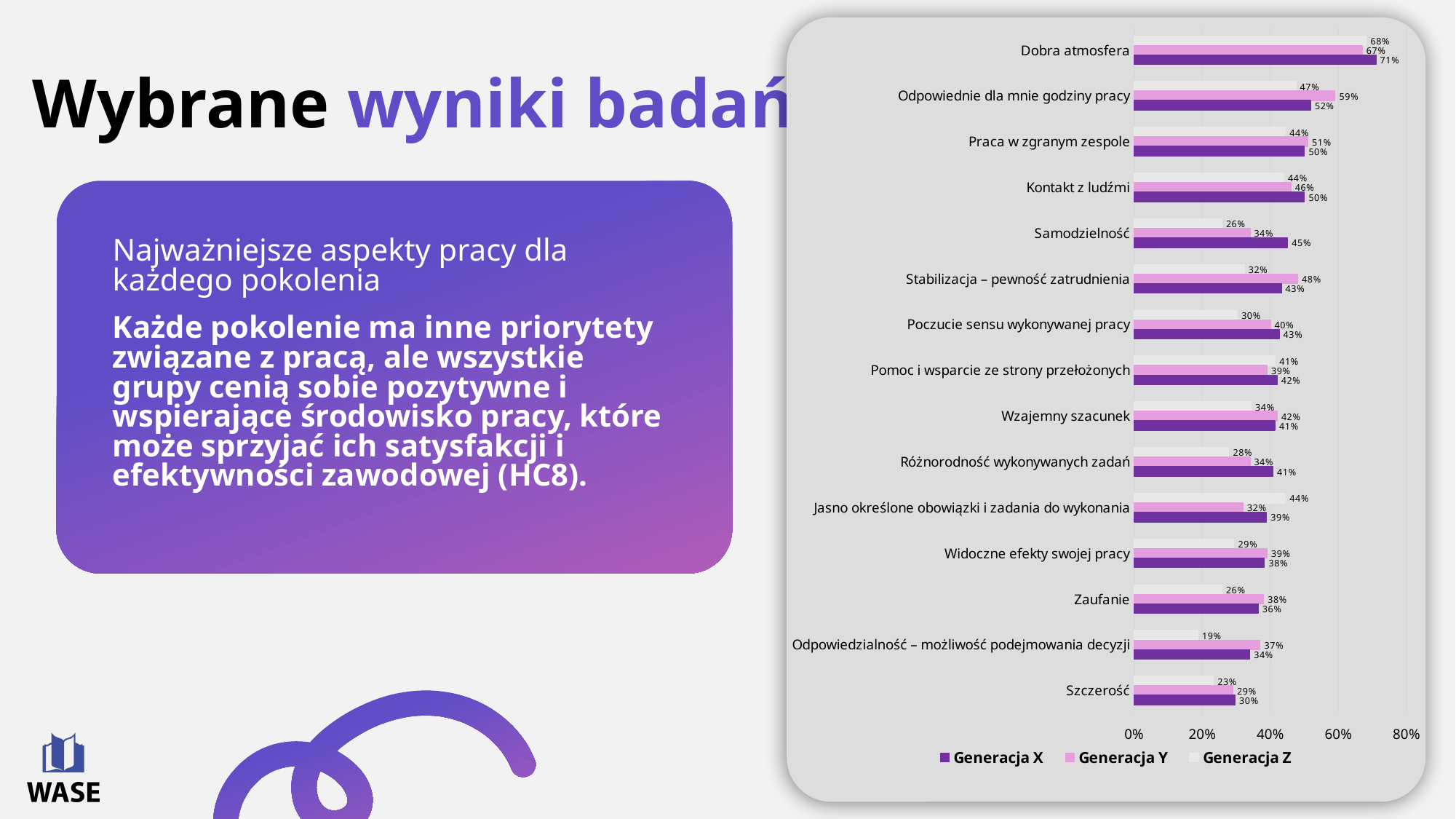
What is the value for Generacja Z for "Odpowiedzialność – możliwość podejmowania decyzji"? 19% How many categories are shown in the chart? 15 What is the difference between the Generacja X and Generacja Z values for "Samodzielność"? 19% For "Stabilizacja – pewność zatrudnienia", which is larger: the Generacja Y value or the Generacja X value? Generacja Y Which series is shown in dark purple in the legend? Generacja X What is the value for Generacja Y for "Odpowiednie dla mnie godziny pracy"? 59% What kind of chart is shown on the slide? Bar chart Is the Generacja X value for "Szczerość" greater or less than 40%? less How many series does the legend list? 3 Which category has the lowest value for Generacja Z? Odpowiedzialność – możliwość podejmowania decyzji What is the value for Generacja X for "Dobra atmosfera"? 71% Which category has the highest value for Generacja X? Dobra atmosfera